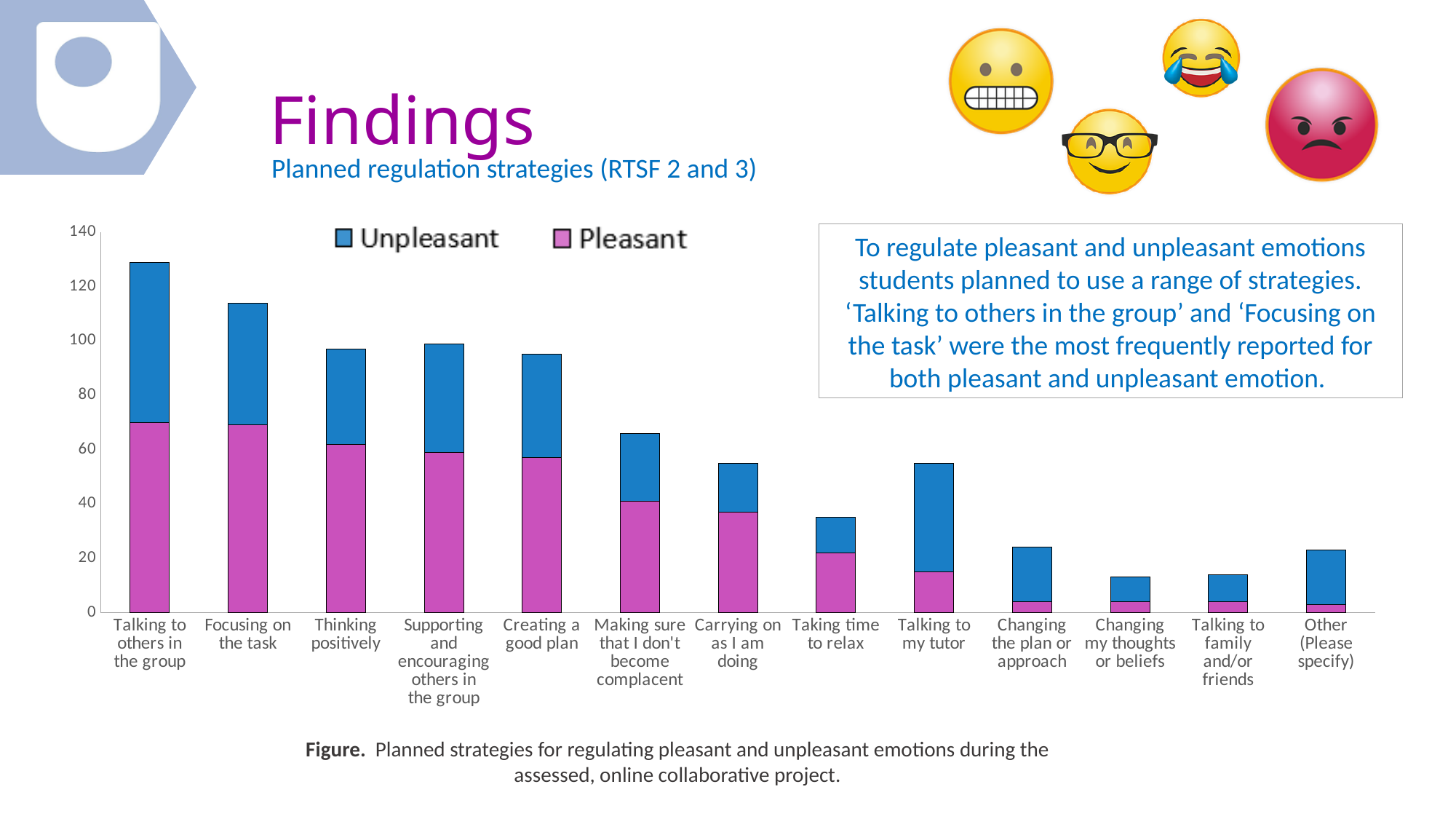
Is the Pleasant value for 'Talking to my tutor' greater or less than 20? less How many series does the chart legend list? 2 Is the total value for 'Talking to others in the group' greater or less than 120? greater Which two series are listed in the chart legend? Unpleasant and Pleasant What kind of chart is shown on the slide? Stacked bar chart Is the Pleasant value for 'Talking to others in the group' greater or less than 60? greater How many strategy categories are shown on the x axis of the chart? 13 Which series is shown in blue in the chart? Unpleasant Which strategy has the highest total bar in the chart? Talking to others in the group Which has the larger total bar: 'Focusing on the task' or 'Thinking positively'? Focusing on the task